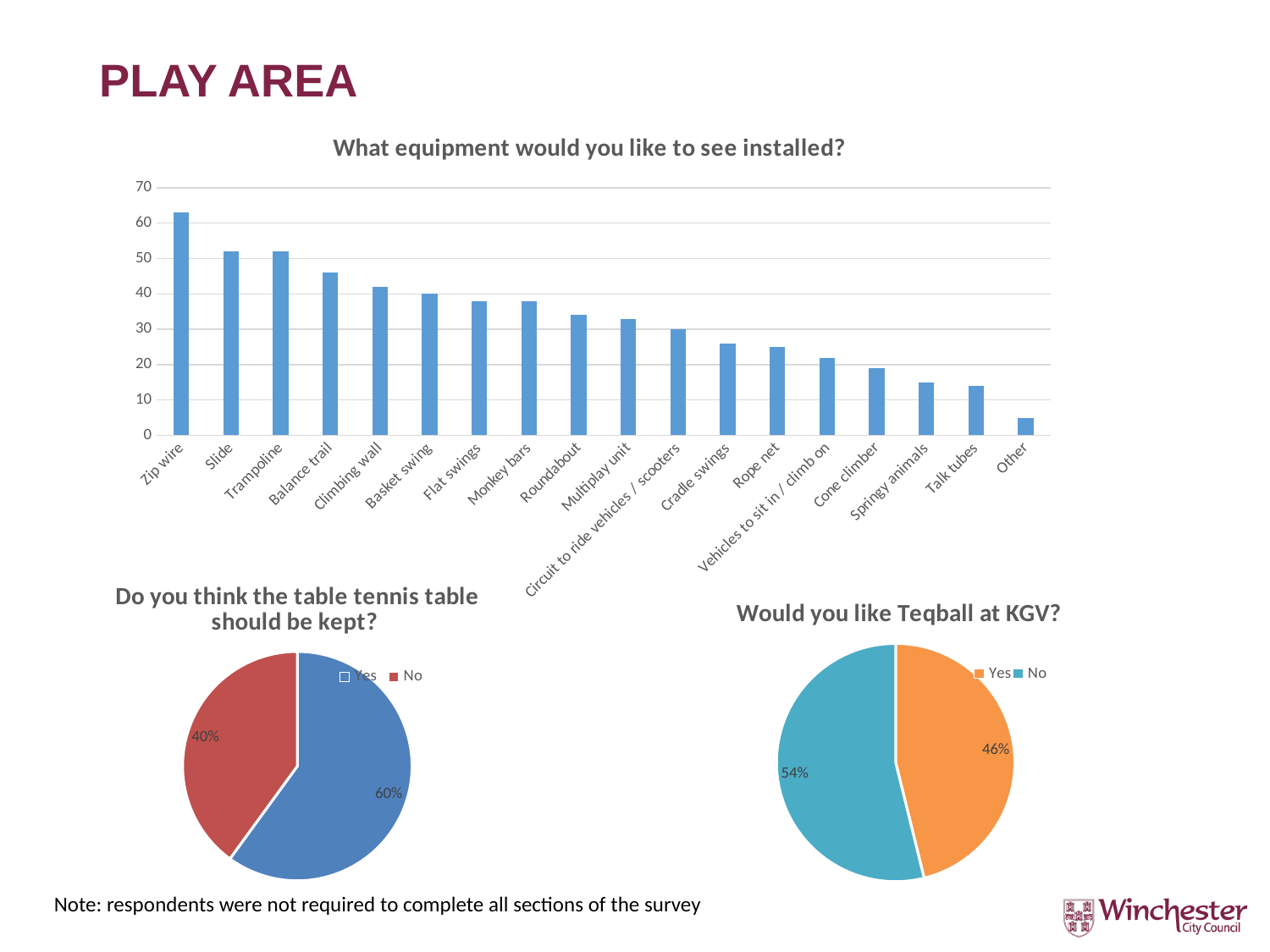
How many equipment categories are shown in the chart 'What equipment would you like to see installed?' 18 In the pie chart 'Would you like Teqball at KGV?', how many percentage points larger is the No share than the Yes share? 8% In the chart 'What equipment would you like to see installed?', which has the larger value, Zip wire or Slide? Zip wire In the pie chart 'Do you think the table tennis table should be kept?', what percentage answered Yes? 60% In the pie chart 'Would you like Teqball at KGV?', what percentage answered No? 54% In the chart 'What equipment would you like to see installed?', is the value for Rope net greater or less than 30? less In the chart 'What equipment would you like to see installed?', do the values rise or fall from left to right along the x axis? Fall In the chart 'What equipment would you like to see installed?', which equipment received the highest number of responses? Zip wire In the chart 'What equipment would you like to see installed?', which category has the lowest bar? Other What kind of chart is 'What equipment would you like to see installed?' Bar chart In the chart 'What equipment would you like to see installed?', is the value for Balance trail greater or less than 50? less In the chart 'What equipment would you like to see installed?', is the value for Zip wire greater or less than 60? greater